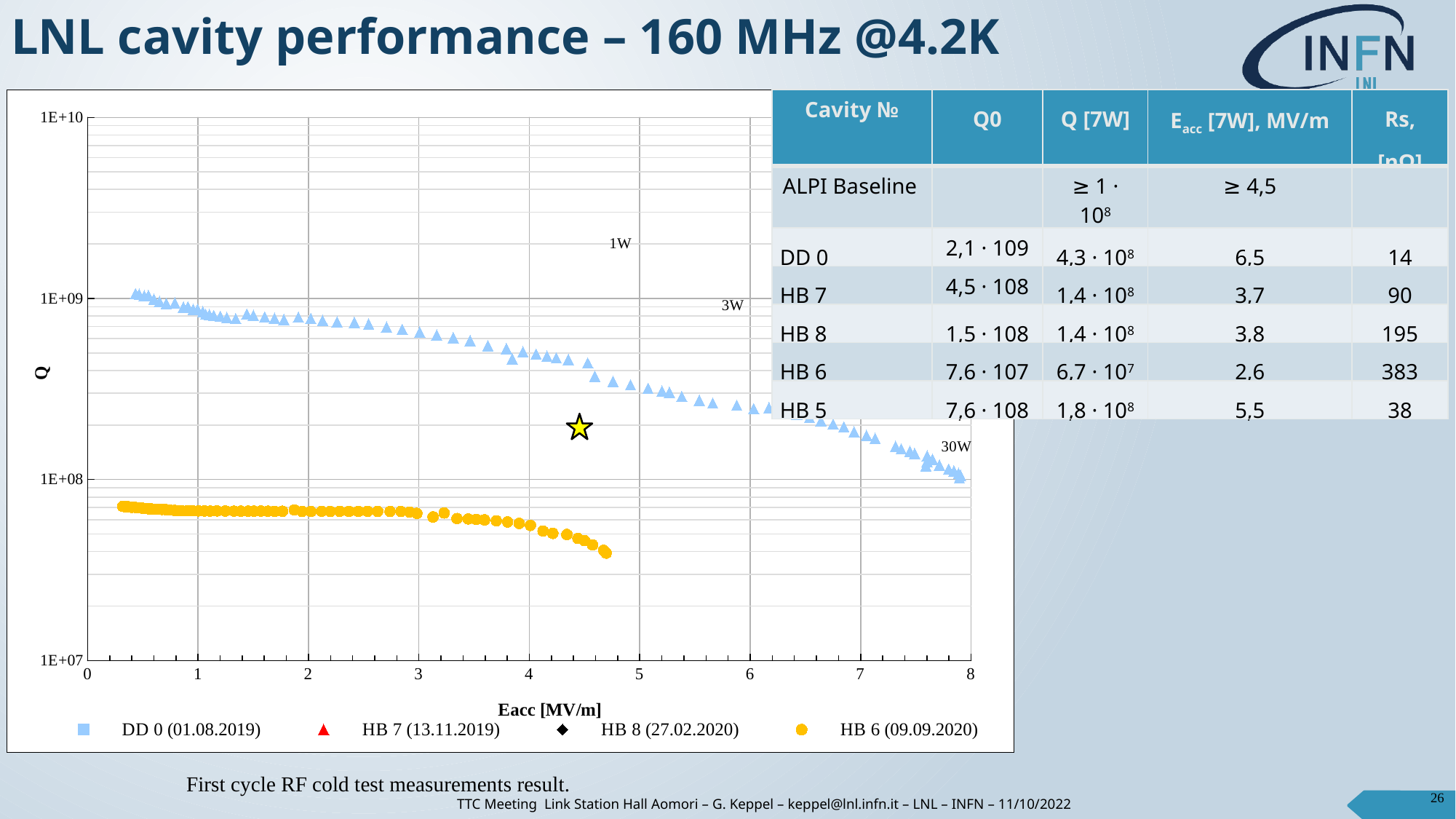
At Eacc = 2 MV/m, which series has the higher Q: DD 0 (01.08.2019) or HB 6 (09.09.2020)? DD 0 (01.08.2019) What is the title of the y axis of the chart? Q What is the highest value shown on the x axis of the chart? 8 What is the title of the x axis of the chart? Eacc [MV/m] Does the Q value of the HB 6 (09.09.2020) series rise or fall as Eacc increases beyond 3 MV/m? fall Which series reaches the highest Eacc value on the chart? DD 0 (01.08.2019) Is the Q value of the DD 0 (01.08.2019) series at Eacc = 3 MV/m greater or less than 1E+08? greater Does the Q value of the DD 0 (01.08.2019) series rise or fall as Eacc increases? fall How many series does the chart legend list? 4 Is the Q value of the HB 6 (09.09.2020) series at Eacc = 1 MV/m greater or less than 1E+08? less What kind of chart is shown on the slide? scatter chart Is the Q value of the DD 0 (01.08.2019) series at Eacc = 5 MV/m greater or less than 1E+09? less